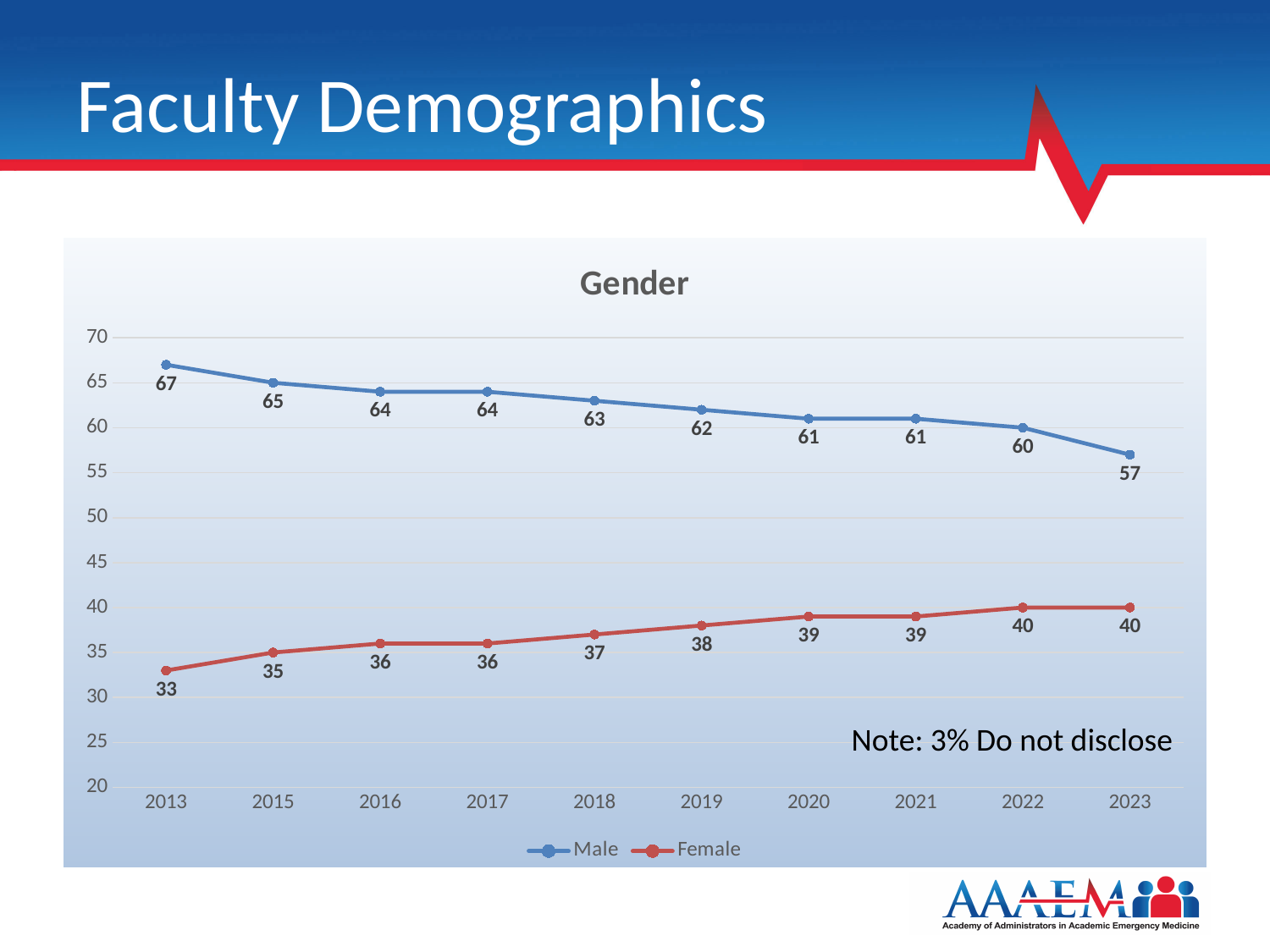
What is the Female value for 2023? 40 Which is larger in 2018, the Male value or the Female value? Male In which year is the Male value lowest? 2023 What is the Male value for 2013? 67 How many years are shown on the x axis? 10 Does the Female series rise or fall from 2013 to 2023? Rise By how much did the Male value fall from 2013 to 2023? 10 What kind of chart is shown? Line chart How many series does the legend list? 2 In which year is the Female value lowest? 2013 What is the difference between the Male and Female values in 2023? 17 What is the Male value for 2019? 62